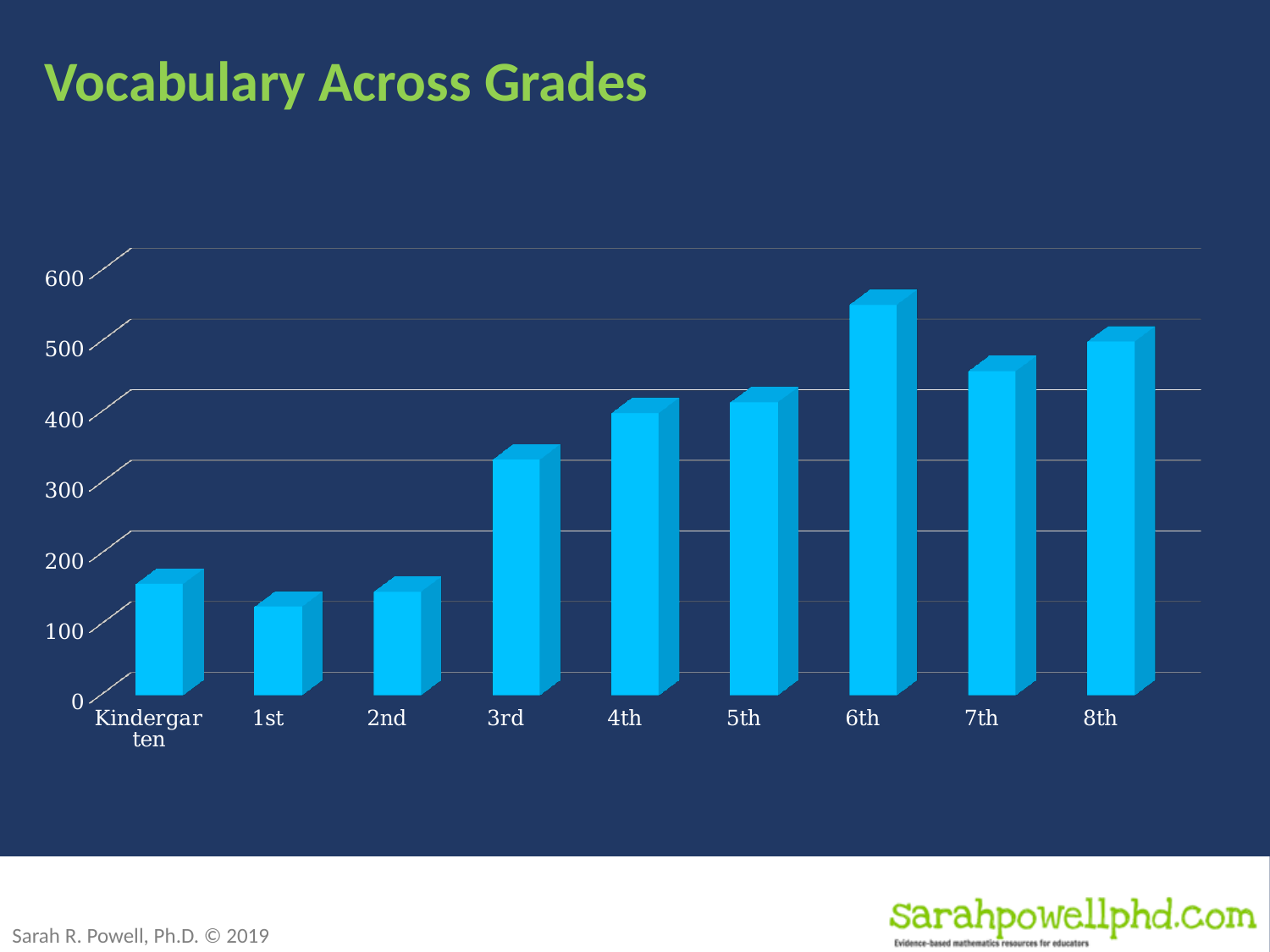
Which is larger, the value for 6th grade or the value for 8th grade? 6th Is the value for 3rd grade greater or less than 400? less Which grade has the highest bar? 6th Is the value for 1st grade greater or less than 200? less Is the value for 8th grade greater or less than 400? greater How many grade categories are shown on the x axis? 9 What is the title of the chart? Vocabulary Across Grades Which is larger, the value for 3rd grade or the value for 4th grade? 4th Which grade has the lowest bar? 1st What kind of chart is shown on the slide? bar chart